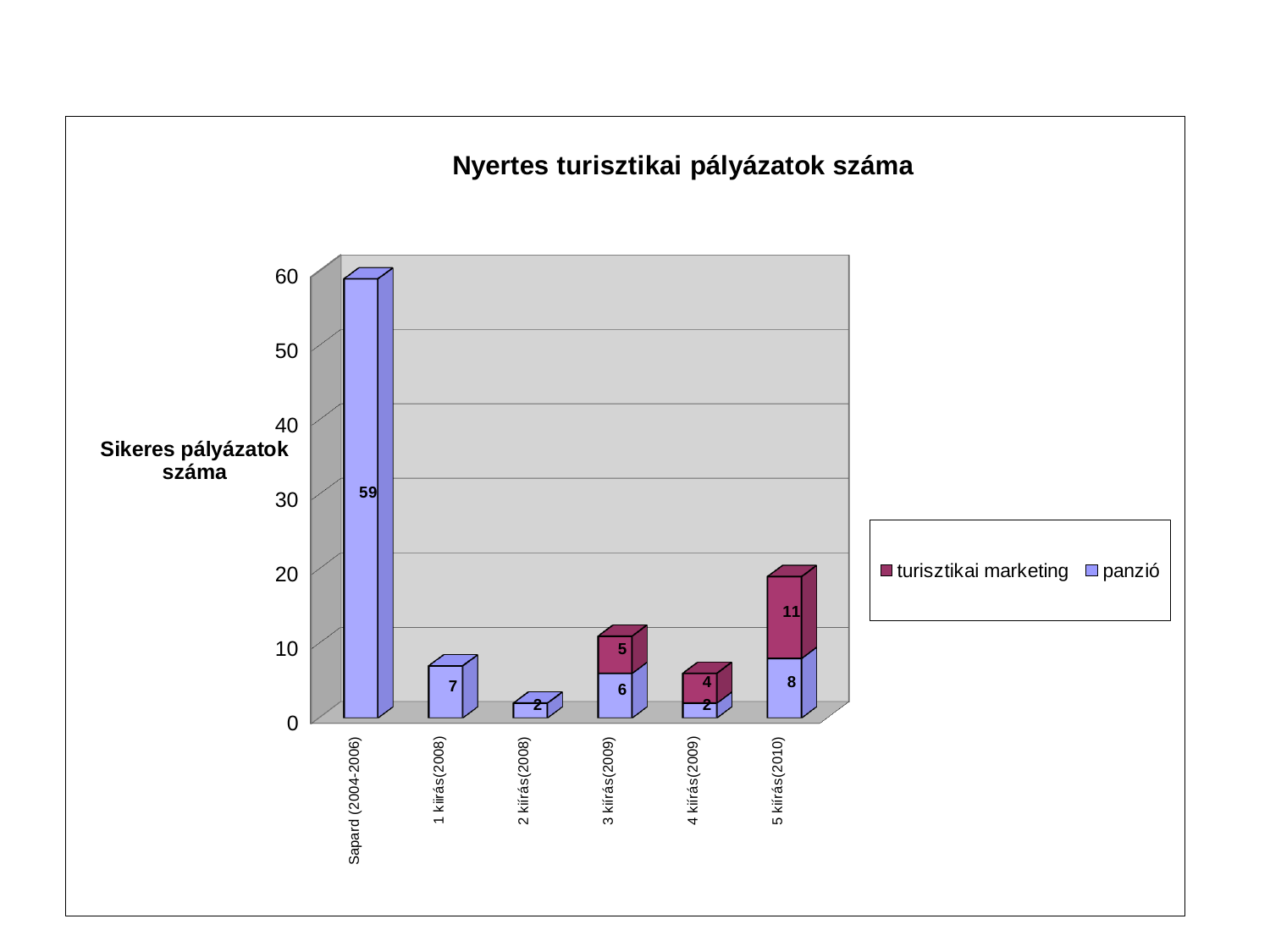
What is the difference between the panzió values for 1 kiírás(2008) and 2 kiírás(2008)? 5 What is the title of the chart? Nyertes turisztikai pályázatok száma How many series does the legend list? 2 What is the panzió value for Sapard (2004-2006)? 59 Which category has the highest turisztikai marketing value? 5 kiírás(2010) What is the panzió value for 3 kiírás(2009)? 6 What is the total of the stacked bar for 5 kiírás(2010)? 19 How many categories are shown on the x axis? 6 What is the turisztikai marketing value for 5 kiírás(2010)? 11 Which is larger, the turisztikai marketing value for 3 kiírás(2009) or for 4 kiírás(2009)? 3 kiírás(2009) What type of chart is shown on the slide? stacked bar chart Which category has the highest panzió value? Sapard (2004-2006)